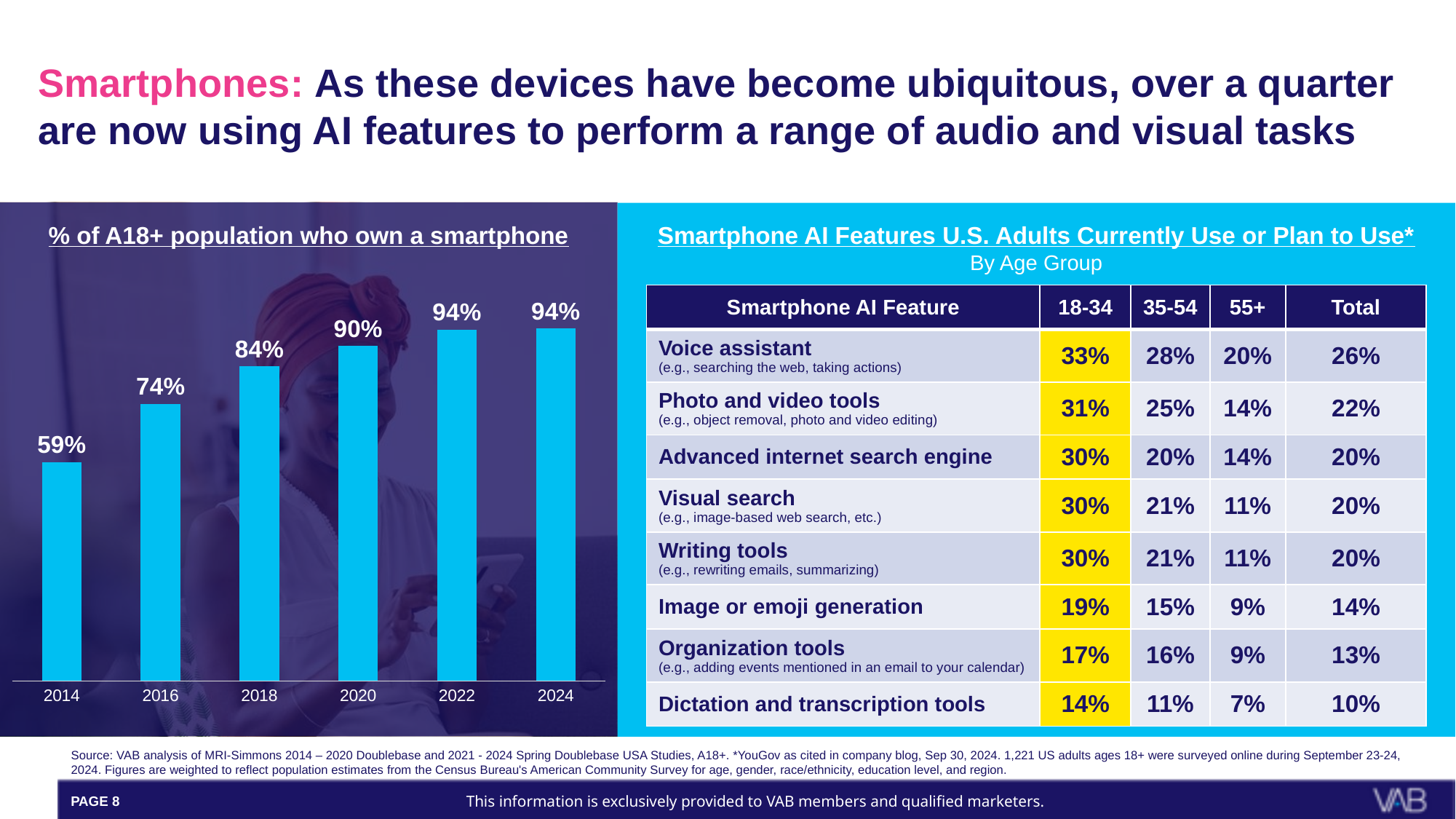
What kind of chart is used to show the % of A18+ population who own a smartphone? Bar chart How many years are shown on the x axis of the smartphone ownership chart? 6 What is the difference in smartphone ownership between 2016 and 2014? 15% Which year has the lowest smartphone ownership percentage in the chart? 2014 What is the value shown for 2024 in the smartphone ownership chart? 94% What is the value shown for 2018 in the smartphone ownership chart? 84% Which is larger, the smartphone ownership value for 2018 or for 2020? 2020 Do the smartphone ownership values rise or fall from 2014 to 2022? Rise What is the title of the chart on the left side of the slide? % of A18+ population who own a smartphone What percentage of the A18+ population owned a smartphone in 2014? 59% What percentage of the A18+ population owned a smartphone in 2020? 90% By how many percentage points did smartphone ownership increase from 2014 to 2024? 35%